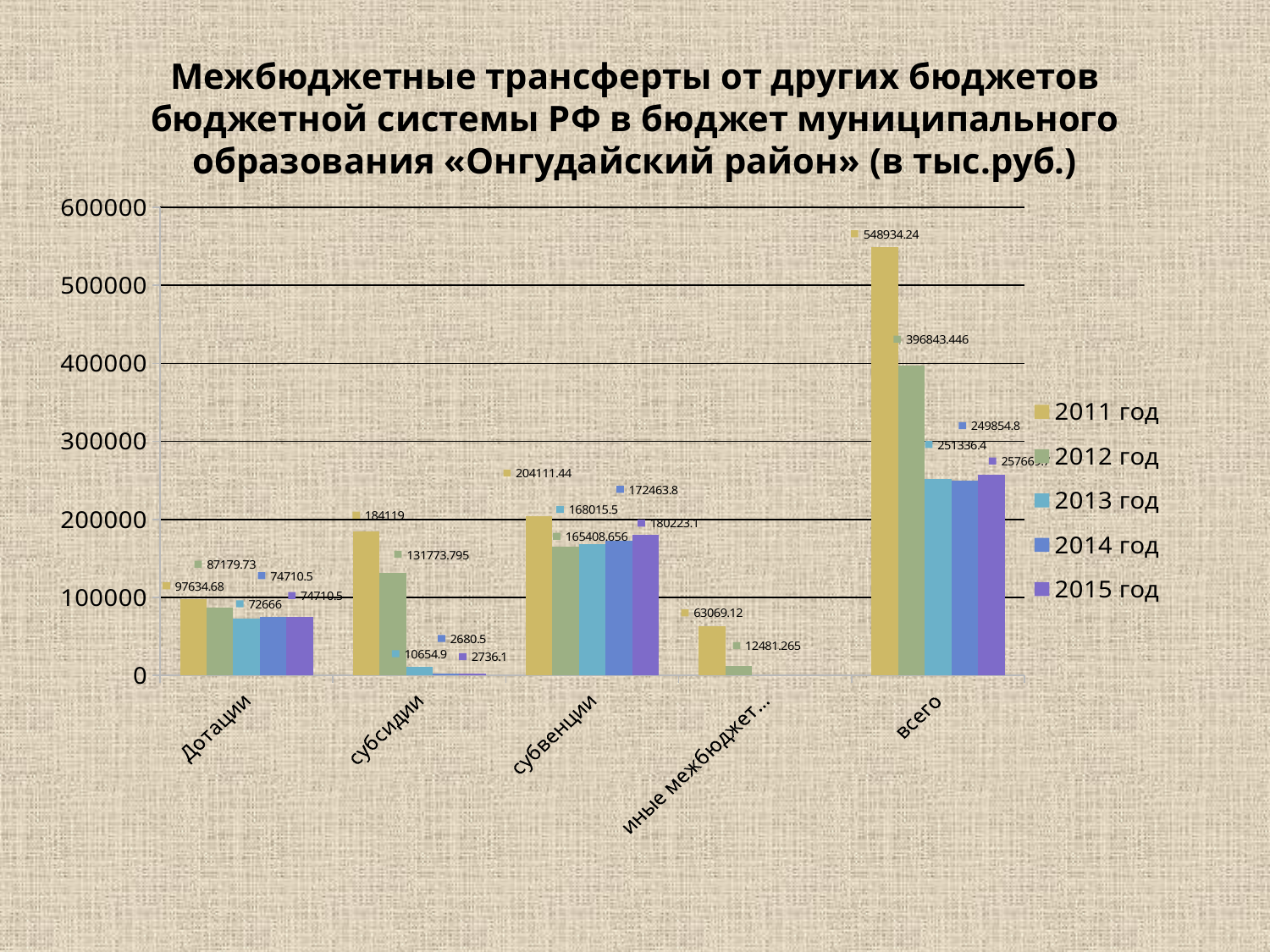
Which year has the highest value in the всего category? 2011 год How many series does the legend list? 5 What is the difference between the 2011 год and 2012 год values in the Дотации category? 10454.95 What is the value for 2011 год in the Дотации category? 97634.68 Is the value for 2013 год in the всего category greater or less than 200000? greater In the субвенции category, which is larger: the value for 2012 год or for 2013 год? 2013 год Which year has the highest value in the субсидии category? 2011 год How many categories are shown on the x axis? 5 What is the value for 2012 год in the субсидии category? 131773.795 What kind of chart is shown on the slide? bar chart What is the value for 2011 год in the всего category? 548934.24 What is the value for 2014 год in the субвенции category? 172463.8